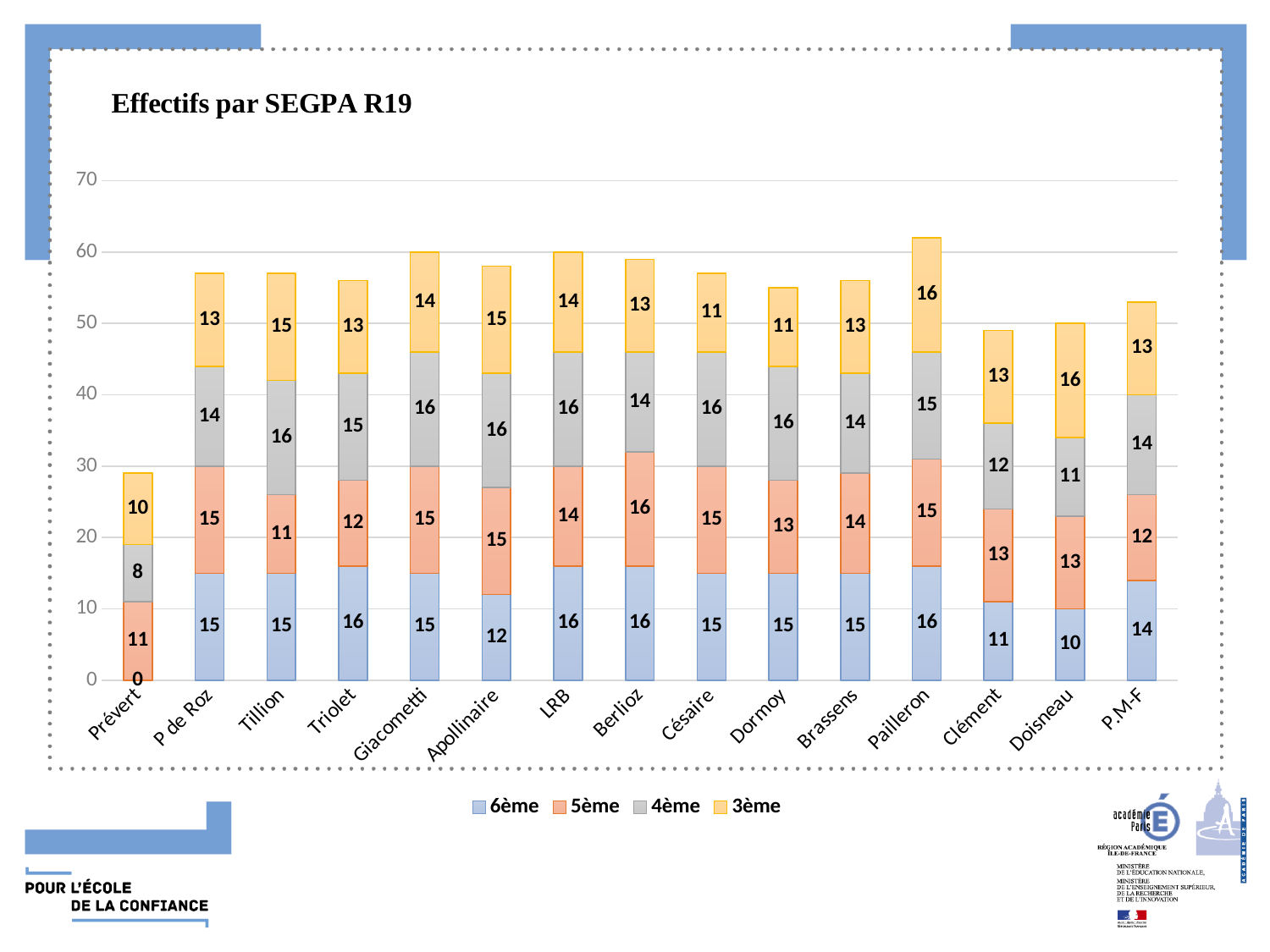
What is the 6ème value for Prévert? 0 What is the title of the chart? Effectifs par SEGPA R19 How many SEGPA categories are shown on the x axis? 15 What is the total of the stacked bar for Pailleron? 62 What is the difference between the 4ème value for Tillion and the 4ème value for Prévert? 8 What is the 5ème value for Berlioz? 16 What is the 3ème value for Pailleron? 16 Which SEGPA has the lowest total effectif? Prévert What is the total of the stacked bar for Prévert? 29 How many series does the legend list? 4 Which SEGPA has the highest total effectif? Pailleron What type of chart is shown on the slide? Stacked bar chart